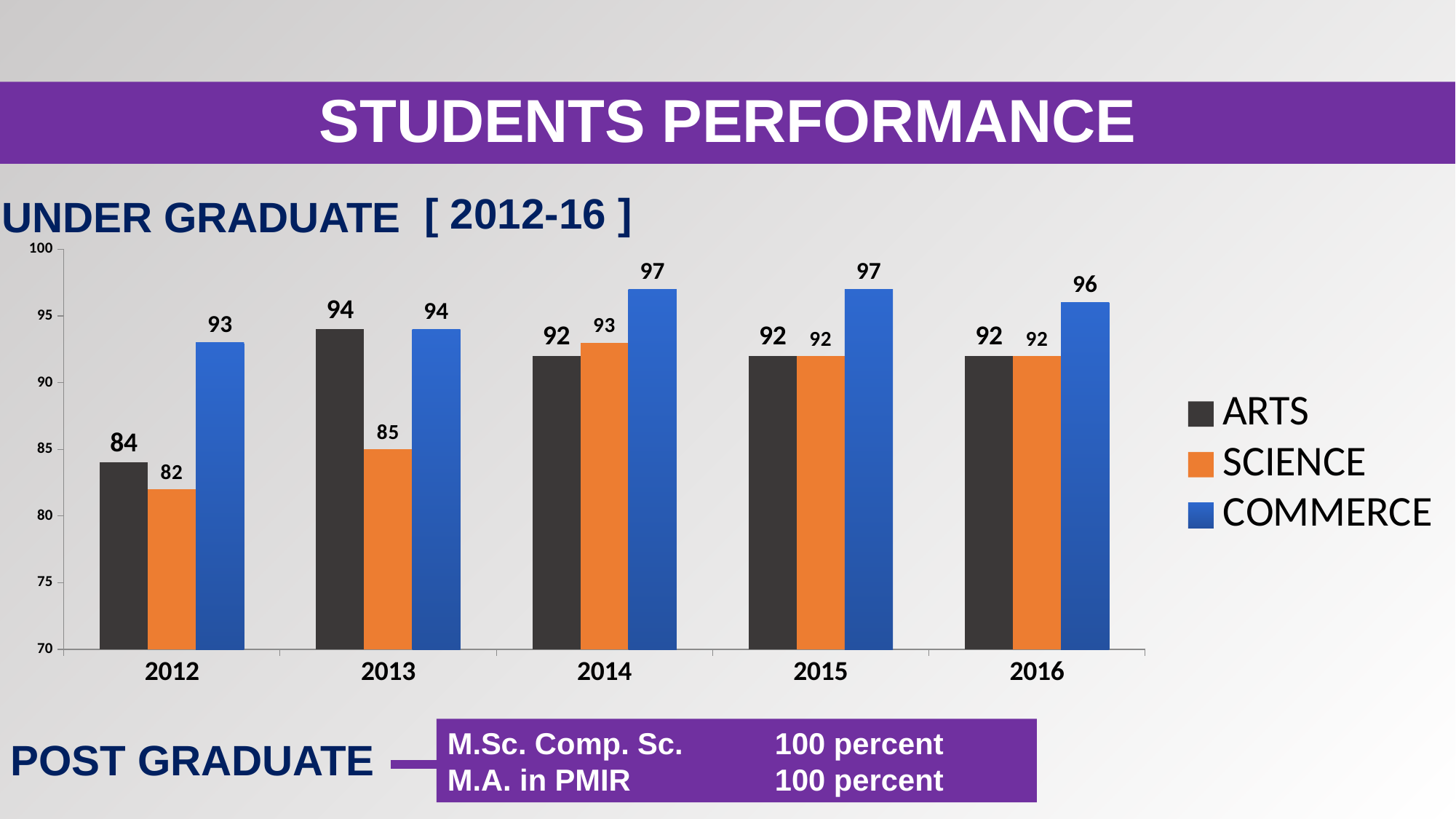
Is the value for SCIENCE in 2013 greater or less than 90? less What is the value for COMMERCE in 2015? 97 Which is larger in 2014, the ARTS value or the COMMERCE value? COMMERCE What is the value for SCIENCE in 2012? 82 What is the difference between the COMMERCE and SCIENCE values in 2013? 9 In which year is the SCIENCE value lowest? 2012 How many series does the legend list? 3 What kind of chart is shown on the slide? bar chart How many years are shown on the x axis? 5 In which year is the ARTS value highest? 2013 Which series is shown in orange in the legend? SCIENCE What is the value for ARTS in 2013? 94